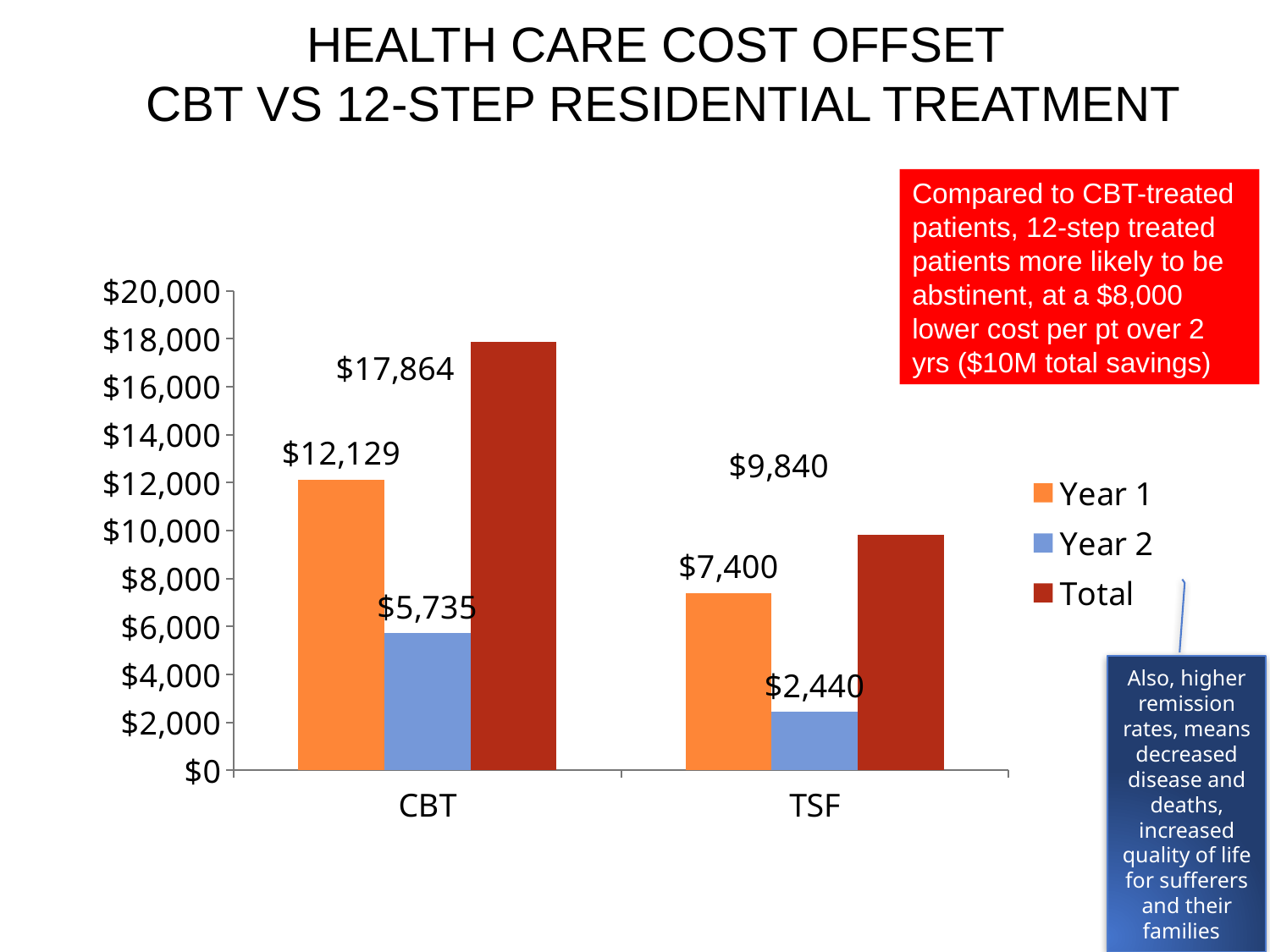
Which category has the lower Year 1 value? TSF How many categories are shown on the x axis? 2 What is the difference between the Total values for CBT and TSF? $8,024 What is the Year 1 value for CBT? $12,129 Is the Total value for CBT greater or less than $16,000? greater Is the Year 1 value for CBT larger than the Year 1 value for TSF? Yes Which category has the higher Total value? CBT How many series does the legend list? 3 What kind of chart is shown? Bar chart What is the Year 2 value for CBT? $5,735 What is the Year 2 value for TSF? $2,440 What is the Total value for TSF? $9,840